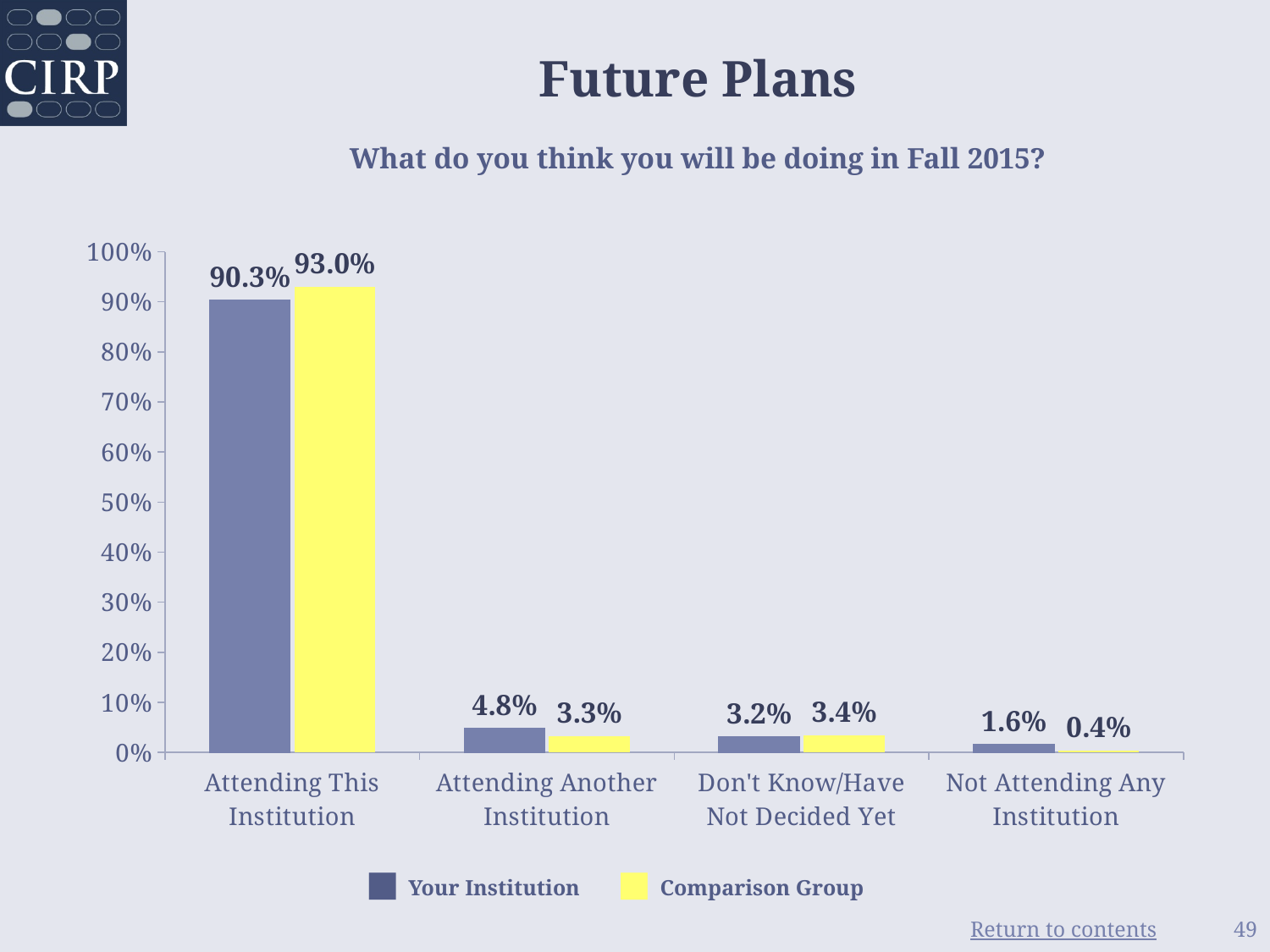
Is the value for Your Institution for Attending This Institution greater or less than 80%? greater What is the difference between Your Institution and Comparison Group for Attending Another Institution? 1.5% What is the difference between Comparison Group and Your Institution for Attending This Institution? 2.7% What kind of chart is shown on the slide? bar chart For Don't Know/Have Not Decided Yet, which is larger: Your Institution or Comparison Group? Comparison Group Which category has the highest value for Comparison Group? Attending This Institution What is the value for Your Institution for Attending This Institution? 90.3% Which category has the lowest value for Your Institution? Not Attending Any Institution How many categories are shown on the x axis? 4 How many series does the legend list? 2 What is the value for Comparison Group for Attending Another Institution? 3.3% What is the value for Your Institution for Not Attending Any Institution? 1.6%